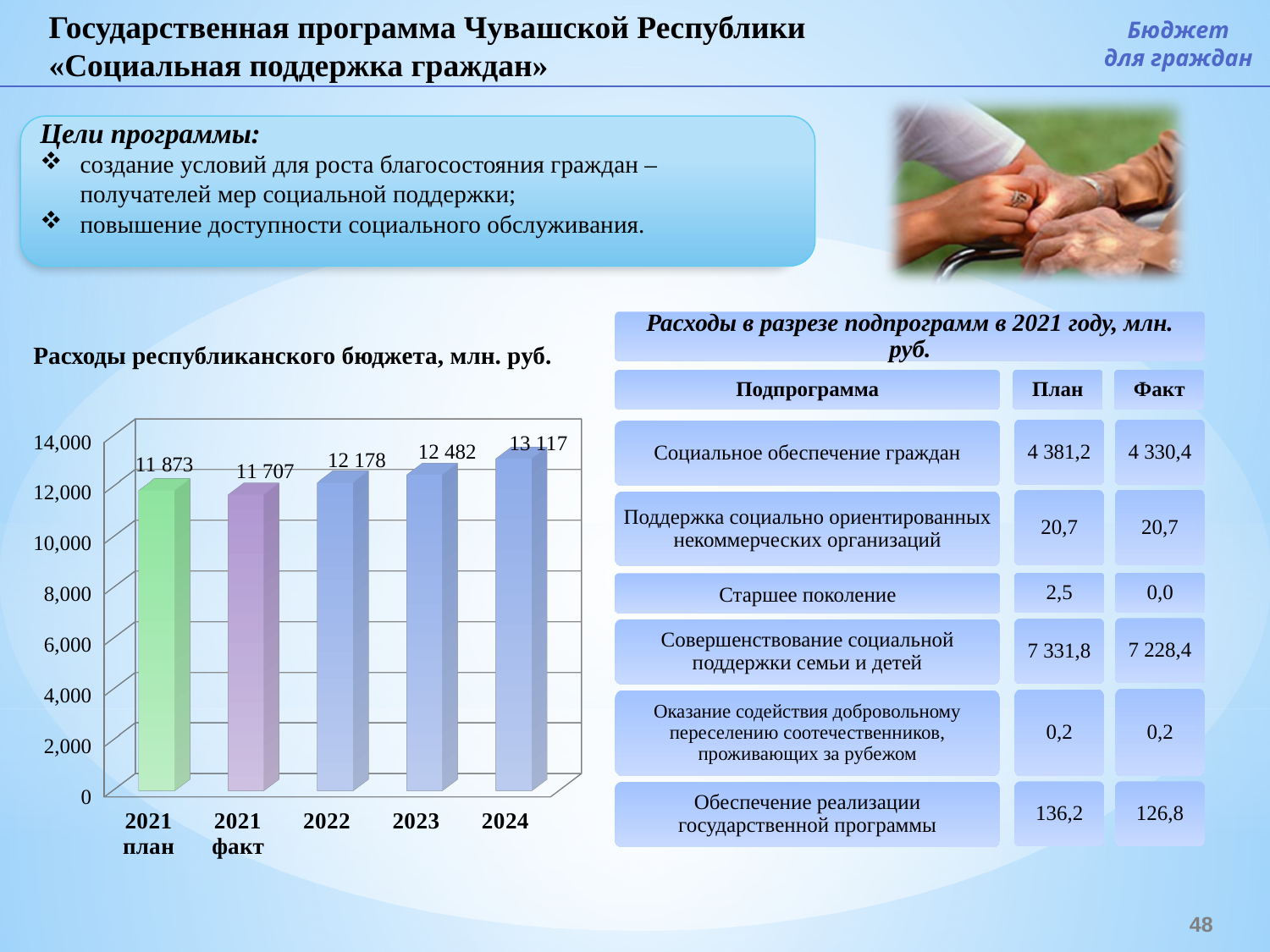
What is the value for 2021 факт in the chart 'Расходы республиканского бюджета, млн. руб.'? 11 707 What is the value for 2021 план in the chart 'Расходы республиканского бюджета, млн. руб.'? 11 873 Which category has the lowest value in the chart 'Расходы республиканского бюджета, млн. руб.'? 2021 факт What is the difference between the 2024 and 2023 values in the chart 'Расходы республиканского бюджета, млн. руб.'? 635 In the chart 'Расходы республиканского бюджета, млн. руб.', which is larger: the value for 2022 or the value for 2023? 2023 In the chart 'Расходы республиканского бюджета, млн. руб.', do the values rise or fall from 2022 to 2024? rise What is the difference between the 2021 план and 2021 факт values in the chart 'Расходы республиканского бюджета, млн. руб.'? 166 How many bars are shown in the chart 'Расходы республиканского бюджета, млн. руб.'? 5 Which category has the highest value in the chart 'Расходы республиканского бюджета, млн. руб.'? 2024 In the chart 'Расходы республиканского бюджета, млн. руб.', is the value for 2024 greater or less than 12,000? greater What is the value for 2024 in the chart 'Расходы республиканского бюджета, млн. руб.'? 13 117 What kind of chart is 'Расходы республиканского бюджета, млн. руб.'? bar chart